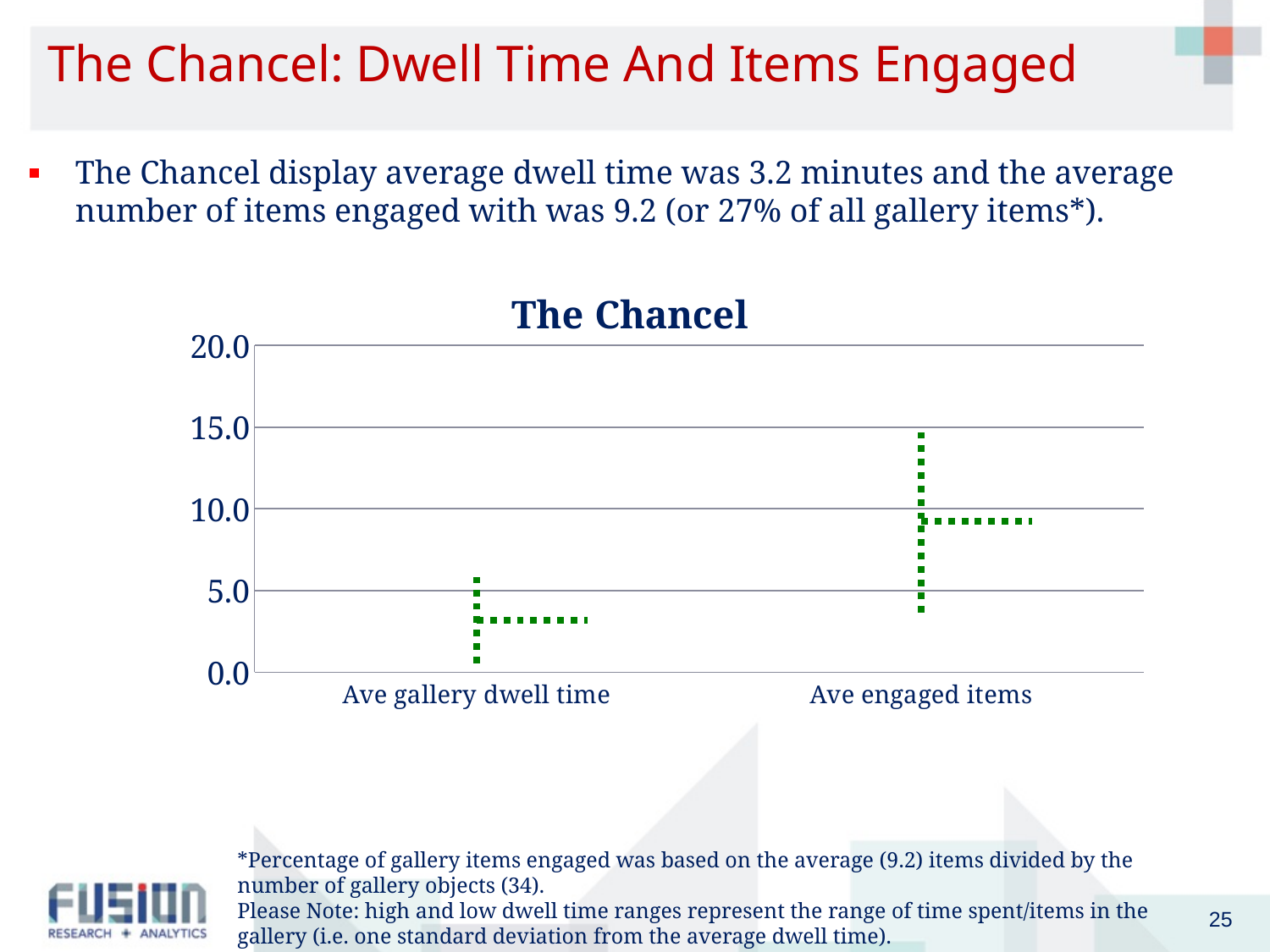
How many categories are shown on the x axis of The Chancel chart? 2 Is the value for Ave engaged items greater or less than 10.0? less What is the title of the chart on the slide? The Chancel Which is larger in The Chancel chart, Ave gallery dwell time or Ave engaged items? Ave engaged items Is the value for Ave engaged items greater or less than 5.0? greater What colour are the plotted markers and range lines in The Chancel chart? Green Which category has the lowest value in The Chancel chart? Ave gallery dwell time Is the value for Ave gallery dwell time greater or less than 5.0? less What is the value for Ave engaged items in The Chancel chart? 9.2 Which category has the highest value in The Chancel chart? Ave engaged items What is the value for Ave gallery dwell time in The Chancel chart? 3.2 minutes